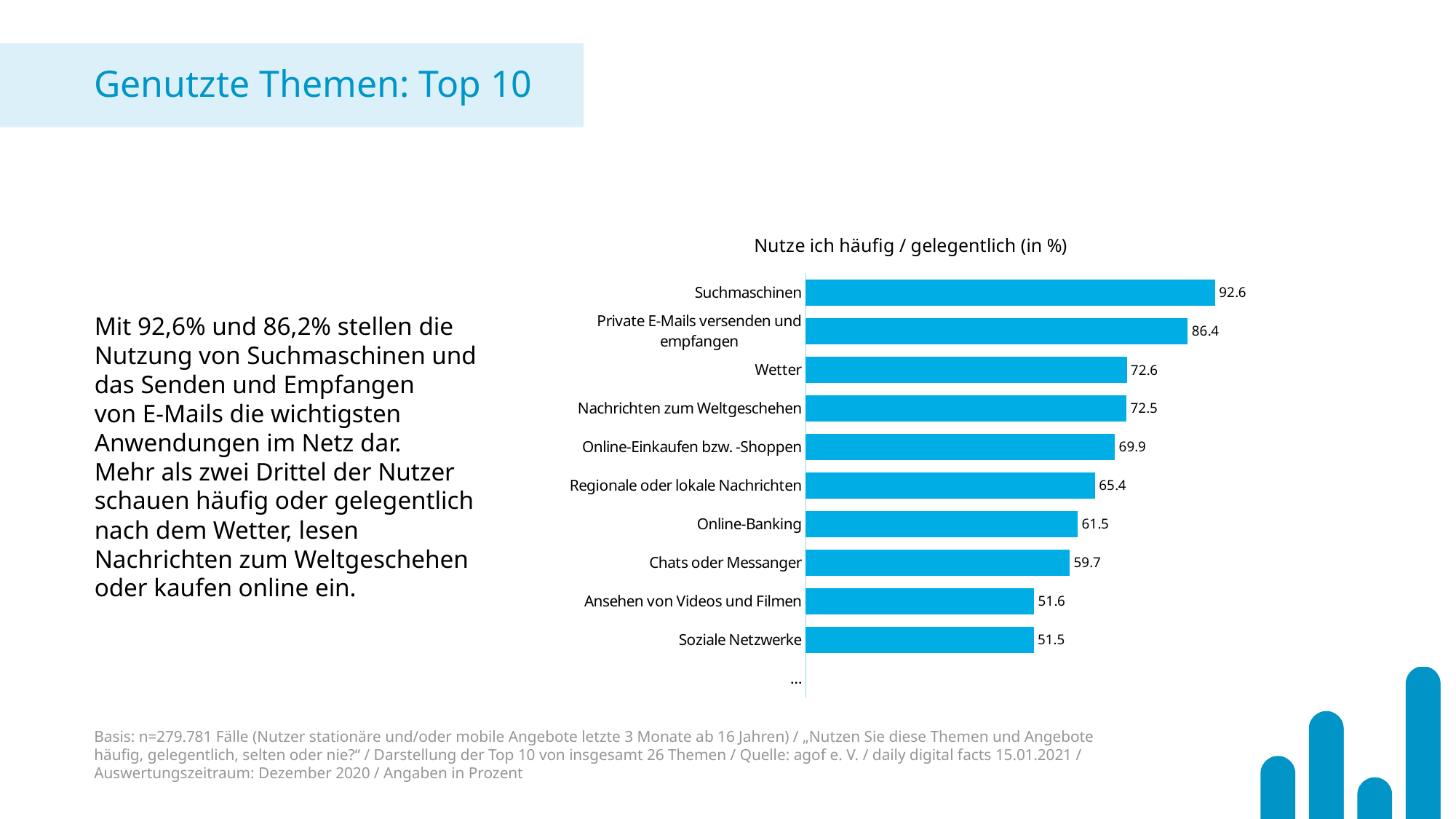
What is the value for Online-Banking? 61.5 Which category has the highest value? Suchmaschinen Which is larger, the value for Wetter or the value for Online-Banking? Wetter What is the title of the chart? Nutze ich häufig / gelegentlich (in %) What is the difference between the values for Online-Einkaufen bzw. -Shoppen and Chats oder Messanger? 10.2 What kind of chart is shown on the slide? Bar chart How many labelled categories with bars are shown in the chart? 10 What colour are the bars in the chart? Blue What is the value for Regionale oder lokale Nachrichten? 65.4 Which labelled category has the lowest value? Soziale Netzwerke What is the value for Suchmaschinen? 92.6 What is the difference between the values for Suchmaschinen and Private E-Mails versenden und empfangen? 6.2